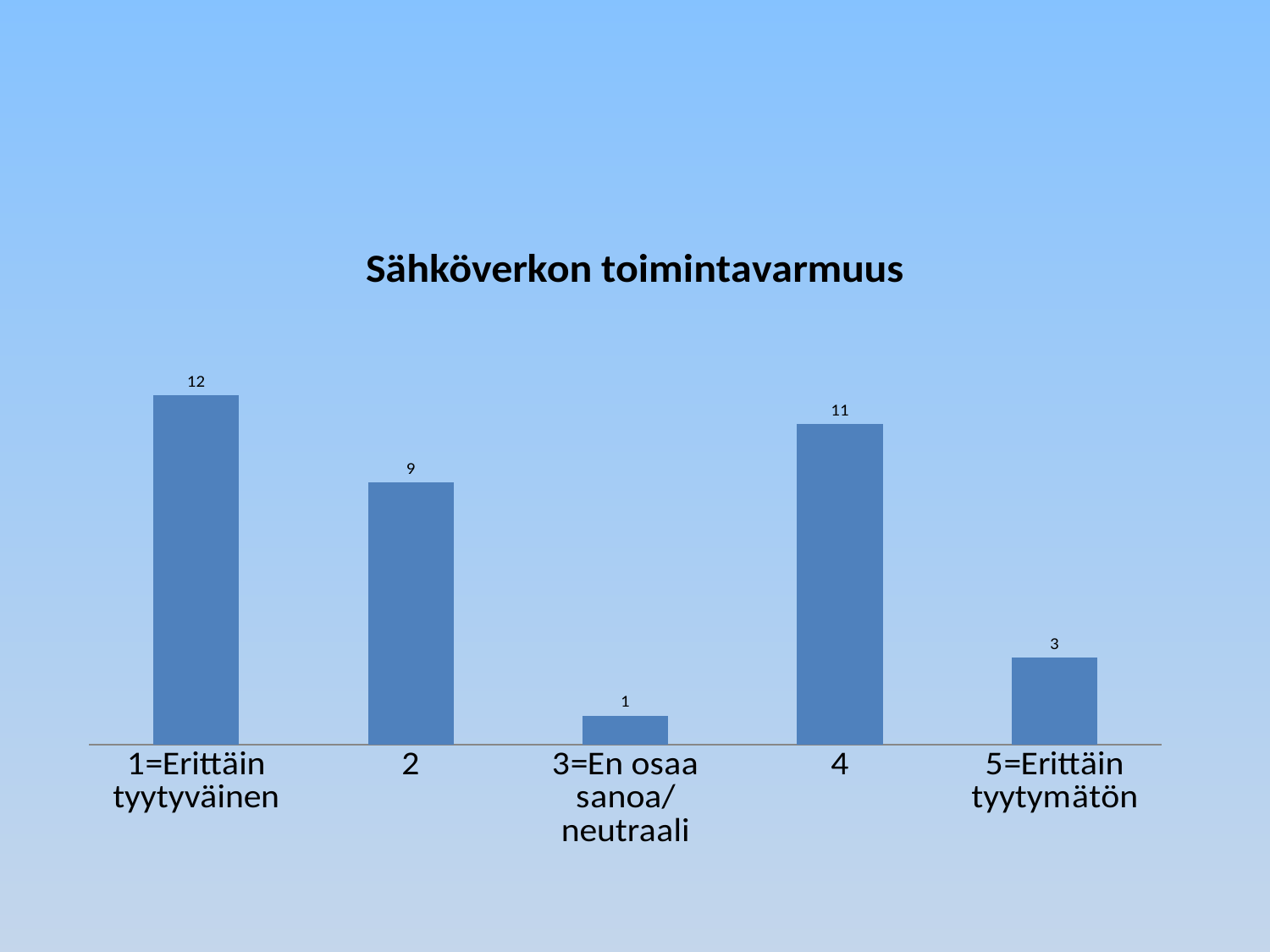
What is the value for '5=Erittäin tyytymätön'? 3 Which is larger, the value for '2' or the value for '5=Erittäin tyytymätön'? 2 Which category has the highest value? 1=Erittäin tyytyväinen What is the value for the category '1=Erittäin tyytyväinen'? 12 What is the title of the chart? Sähköverkon toimintavarmuus Which category has the lowest value? 3=En osaa sanoa/neutraali What is the difference between the values for '1=Erittäin tyytyväinen' and '4'? 1 What is the value for category '4'? 11 What is the value for category '2'? 9 What is the value for '3=En osaa sanoa/neutraali'? 1 What kind of chart is shown on the slide? Bar chart How many categories are shown in the chart? 5